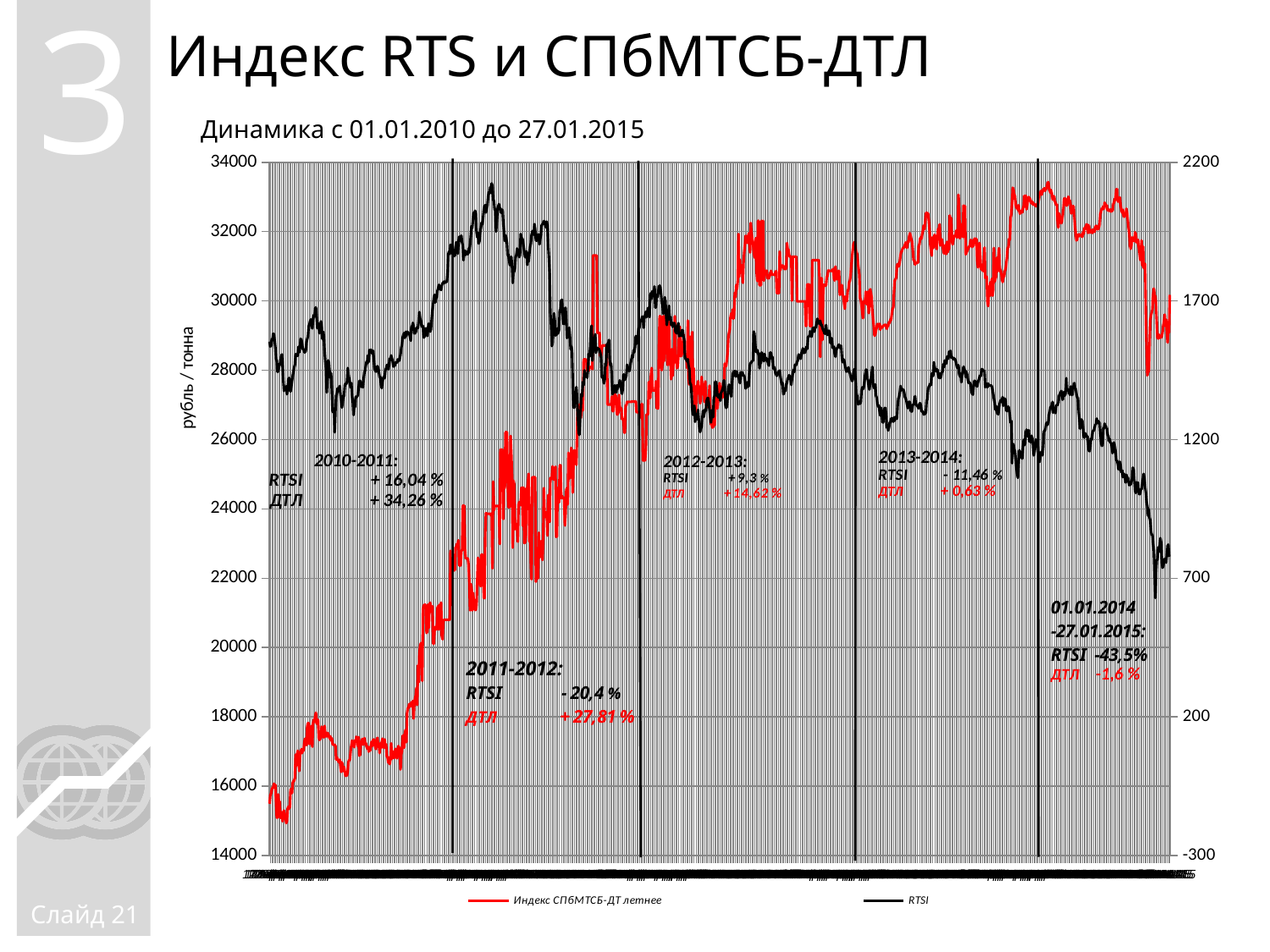
What is the label on the left vertical axis of the chart? рубль / тонна What are the two series named in the chart legend? Индекс СПбМТСБ-ДТ летнее and RTSI According to the annotation on the chart, what was the change in RTSI for 2010-2011? + 16,04 % Does the RTSI line rise or fall over the final period from 01.01.2014 to 27.01.2015? fall Is the value of the Индекс СПбМТСБ-ДТ летнее line at the right end of the chart greater or less than 26000 on the left axis? greater According to the annotation on the chart, what was the change in RTSI from 01.01.2014 to 27.01.2015? -43,5% What kind of chart is shown on the slide? line chart Which annotated period shows the largest percentage gain for ДТЛ? 2010-2011 How many series does the chart legend list? 2 According to the annotation on the chart, what was the change in ДТЛ for 2011-2012? + 27,81 % According to the annotation on the chart, what was the change in ДТЛ for 2013-2014? + 0,63 % In the 2012-2013 period, which had the larger annotated percentage change, RTSI or ДТЛ? ДТЛ